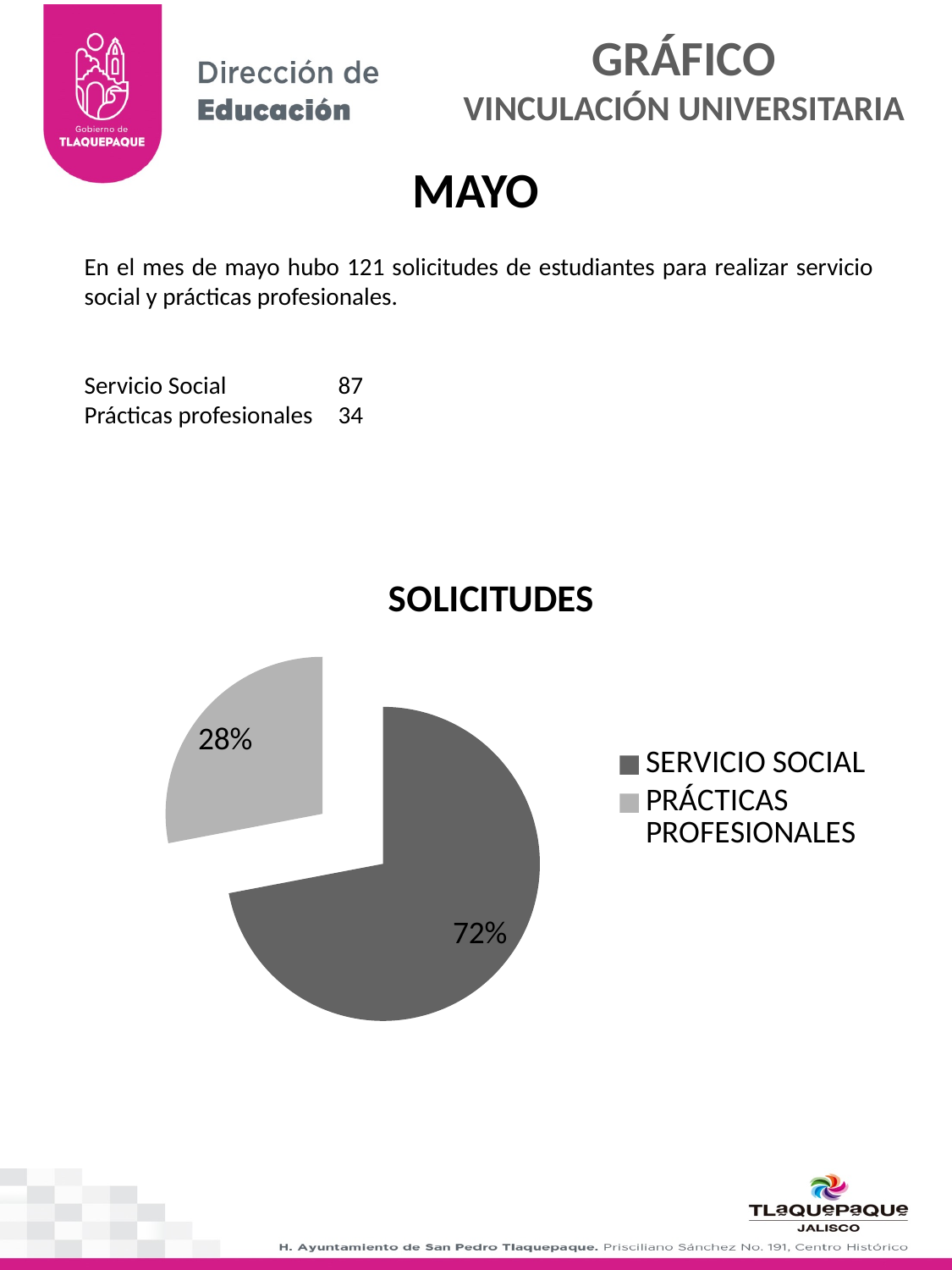
What is the difference in percentage points between the SERVICIO SOCIAL slice and the PRÁCTICAS PROFESIONALES slice? 44 Which is larger, the SERVICIO SOCIAL slice or the PRÁCTICAS PROFESIONALES slice? SERVICIO SOCIAL What percentage of the pie does PRÁCTICAS PROFESIONALES represent? 28% What is the title of the chart? SOLICITUDES What type of chart is shown on the slide? pie chart Which slice of the pie is the smallest? PRÁCTICAS PROFESIONALES How many slices does the pie chart have? 2 How many entries does the legend list? 2 What percentage of the pie does SERVICIO SOCIAL represent? 72% Which legend entry is shown in the lighter grey colour? PRÁCTICAS PROFESIONALES Which slice of the pie is the largest? SERVICIO SOCIAL